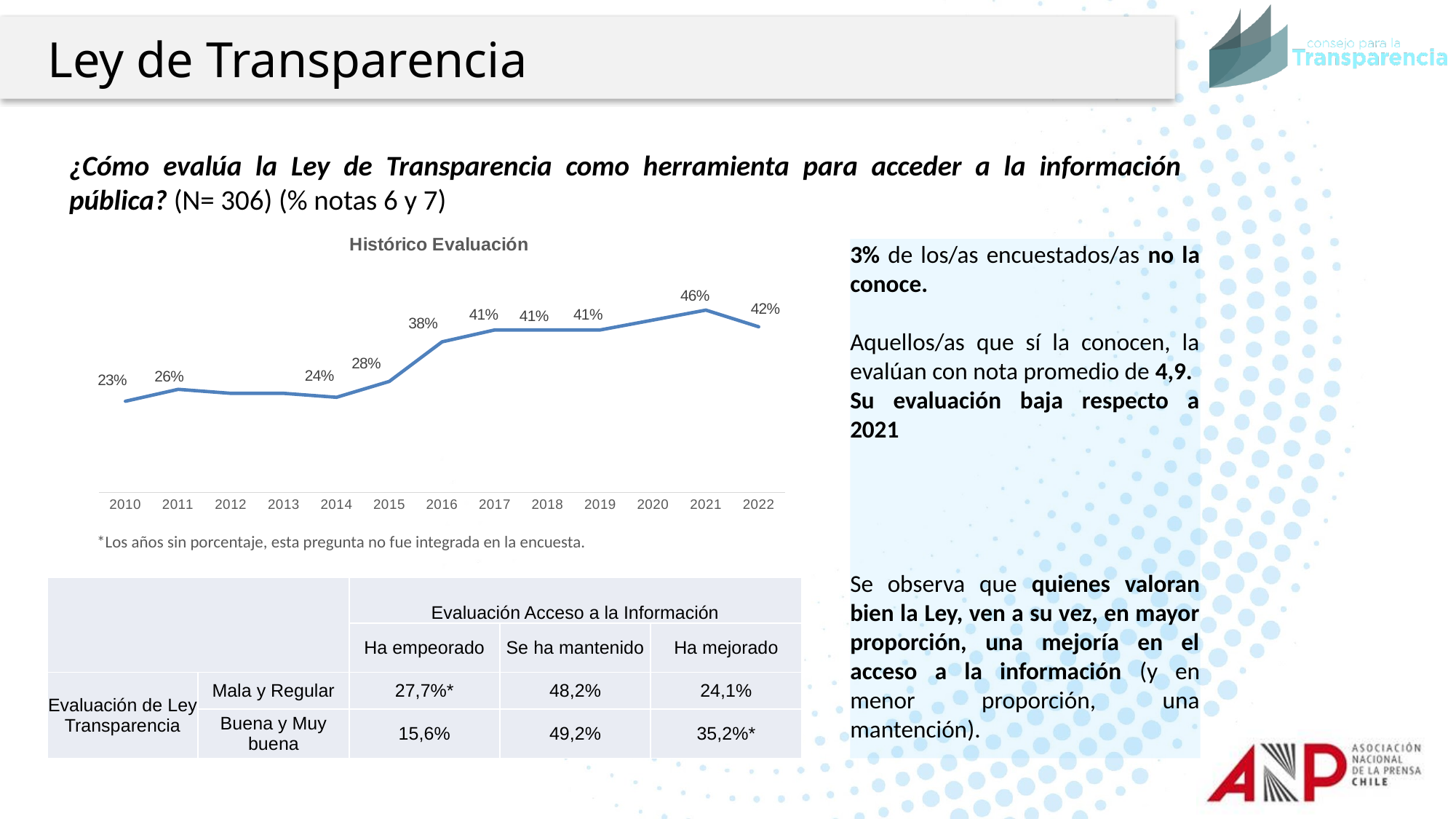
Which year has the lowest value in the Histórico Evaluación chart? 2010 Which is larger in the Histórico Evaluación chart, the value for 2015 or the value for 2016? 2016 What is the value for 2010 in the Histórico Evaluación chart? 23% What is the title of the chart? Histórico Evaluación Which year has the highest value in the Histórico Evaluación chart? 2021 How many years are shown on the x axis of the Histórico Evaluación chart? 13 What is the value for 2016 in the Histórico Evaluación chart? 38% What kind of chart is shown under 'Histórico Evaluación'? line chart What is the difference between the values for 2016 and 2015 in the Histórico Evaluación chart? 10% What is the value for 2022 in the Histórico Evaluación chart? 42% Does the value in the Histórico Evaluación chart rise or fall from 2010 to 2021? rise What is the difference between the values for 2021 and 2022 in the Histórico Evaluación chart? 4%